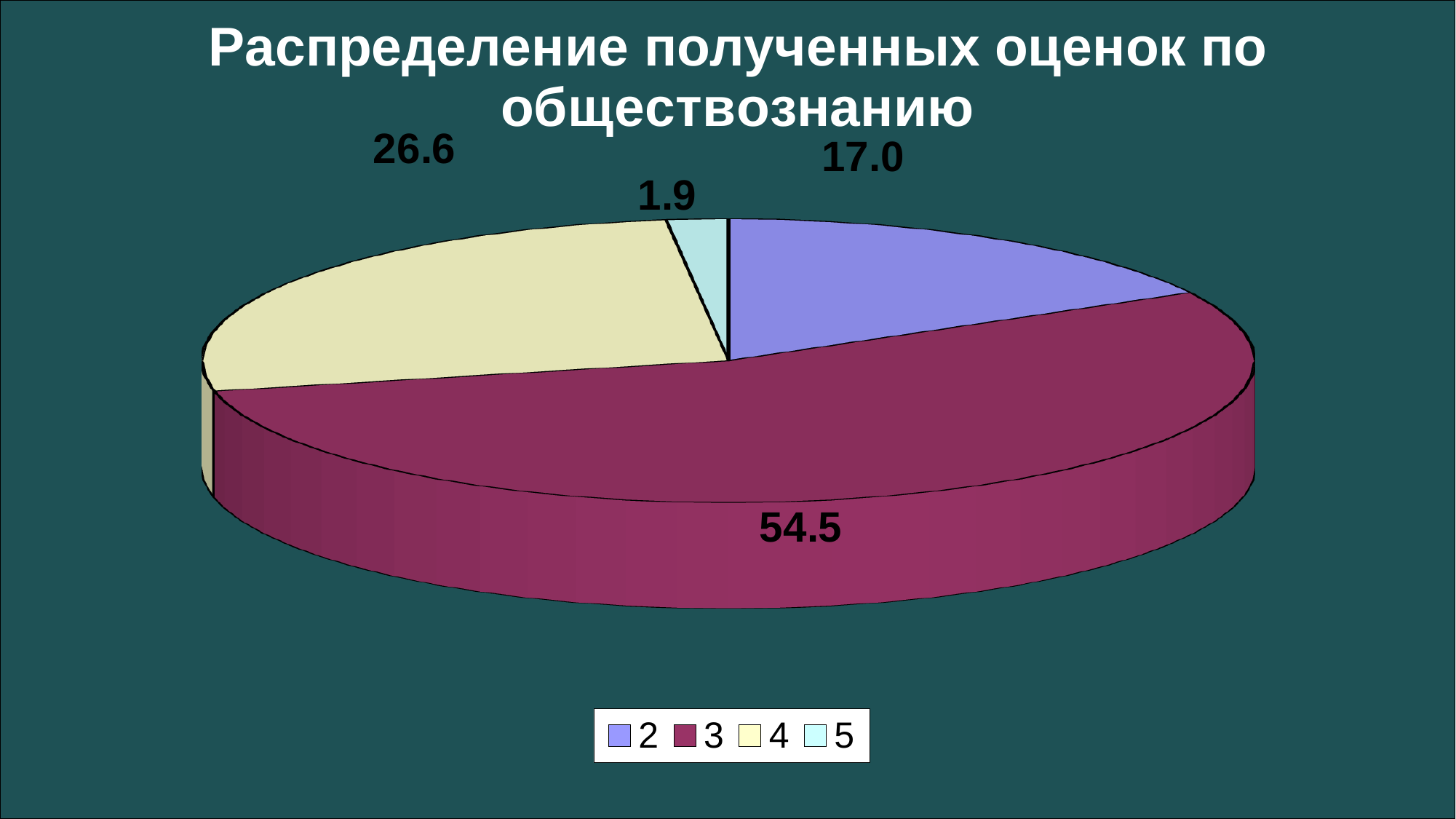
What type of chart is shown on the slide? Pie chart Which grade has the smallest share of the pie? 5 Which grade has the largest share of the pie? 3 What is the difference between the values for grade 3 and grade 4? 27.9 What is the value for grade 3? 54.5 What is the value for grade 4? 26.6 What is the difference between the values for grade 4 and grade 2? 9.6 What is the value for grade 2? 17.0 What is the value for grade 5? 1.9 Which is larger, the value for grade 2 or the value for grade 4? 4 How many categories does the legend list? 4 What is the title of the chart? Распределение полученных оценок по обществознанию